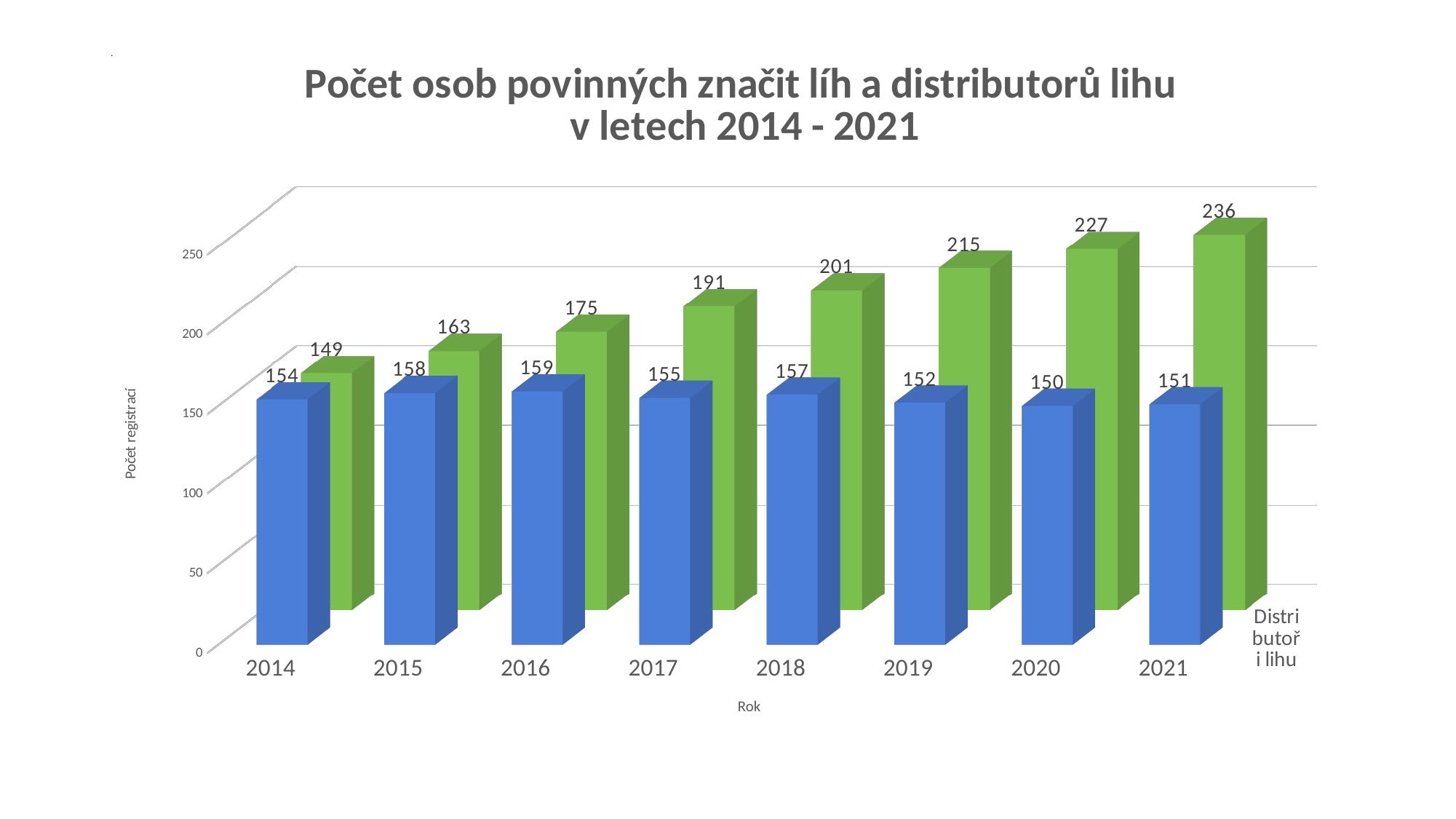
Which is larger in 2014, the blue bar or the green bar? the blue bar In which year is the blue series lowest? 2020 Does the green series rise or fall from 2014 to 2021? rise What is the label of the y axis? Počet registrací What is the value of the green bar for 2014? 149 How many years are shown on the x axis? 8 What kind of chart is shown on the slide? bar chart Is the value of the green bar for 2019 greater or less than 200? greater What is the difference between the green and blue bars in 2021? 85 What is the value of the blue bar for 2016? 159 What is the value of the green bar for 2021? 236 In which year is the green series highest? 2021